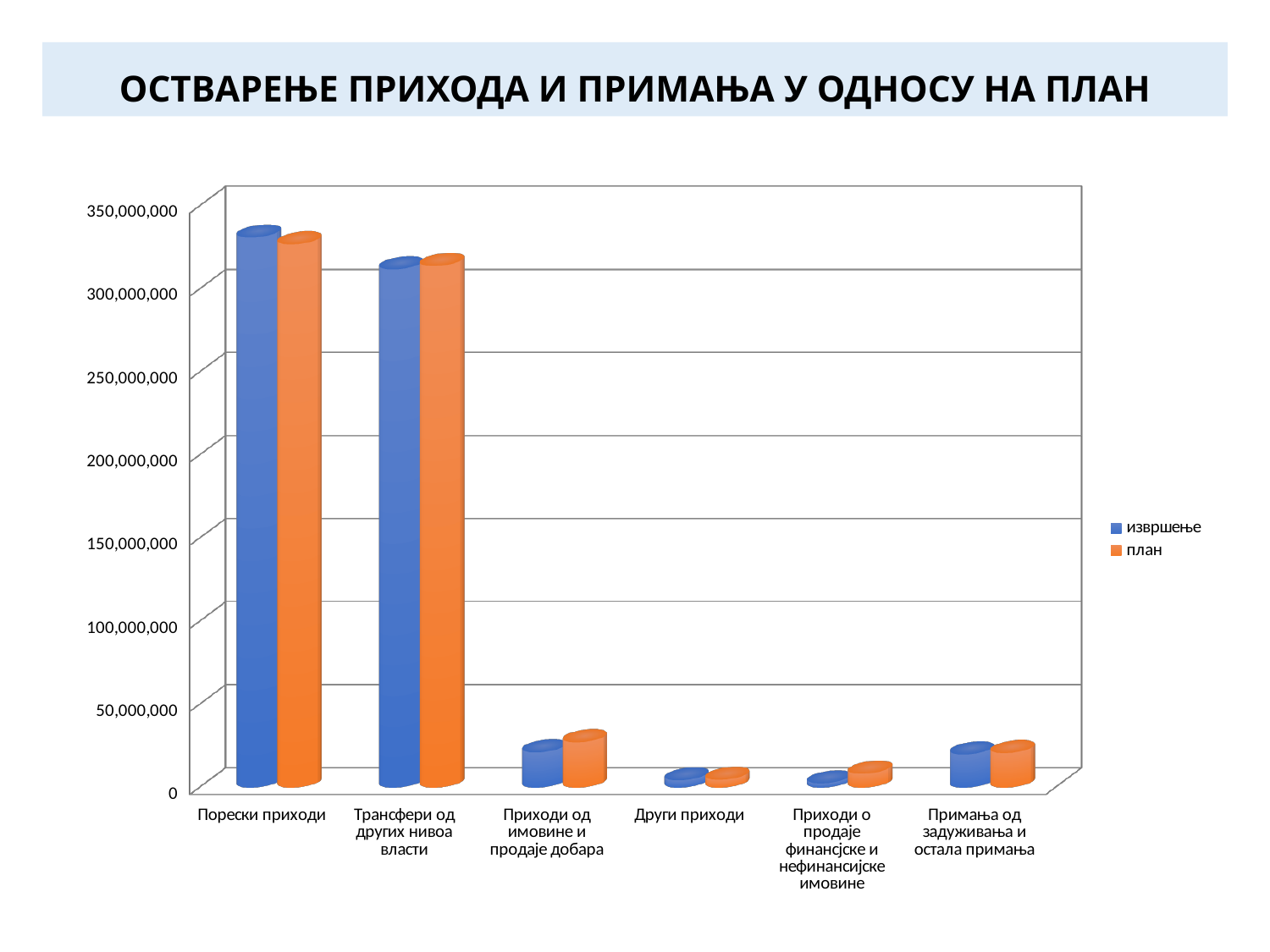
Which category has the highest value for the план series? Порески приходи How many series does the legend list? 2 For the извршење series, which is larger: Порески приходи or Трансфери од других нивоа власти? Порески приходи Is the извршење value for Примања од задуживања и остала примања greater or less than 50,000,000? less For Приходи од имовине и продаје добара, which series has the larger value, извршење or план? план Which category has the highest value for the извршење series? Порески приходи How many categories are shown on the x axis? 6 Is the извршење value for Порески приходи greater or less than 300,000,000? greater Which colour represents the план series in the legend? orange Is the план value for Трансфери од других нивоа власти greater or less than 300,000,000? greater What kind of chart is shown on the slide? bar chart